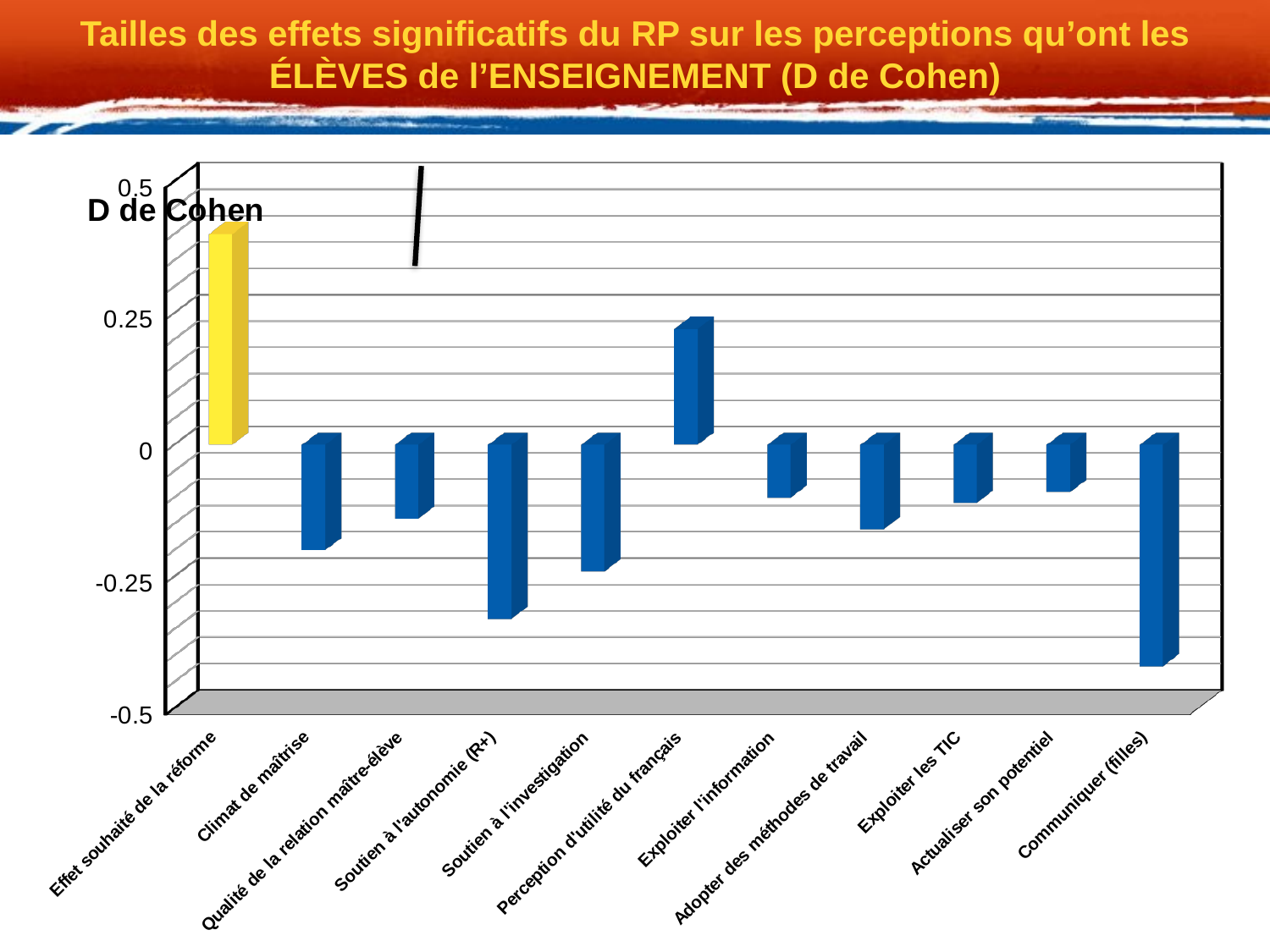
Is the value for Exploiter l'information greater or less than -0.25? greater Is the value for Perception d'utilité du français greater or less than 0? greater Which is larger, the value for Soutien à l'autonomie (R+) or the value for Qualité de la relation maître-élève? Qualité de la relation maître-élève Is the value for Soutien à l'autonomie (R+) greater or less than -0.25? less Which is larger, the value for Climat de maîtrise or the value for Perception d'utilité du français? Perception d'utilité du français Which category has the lowest value in the chart? Communiquer (filles) How many categories are plotted along the x axis of the chart? 11 What colour is the bar for Effet souhaité de la réforme? yellow Which category has the highest value in the chart? Effet souhaité de la réforme What kind of chart is shown on the slide? bar chart